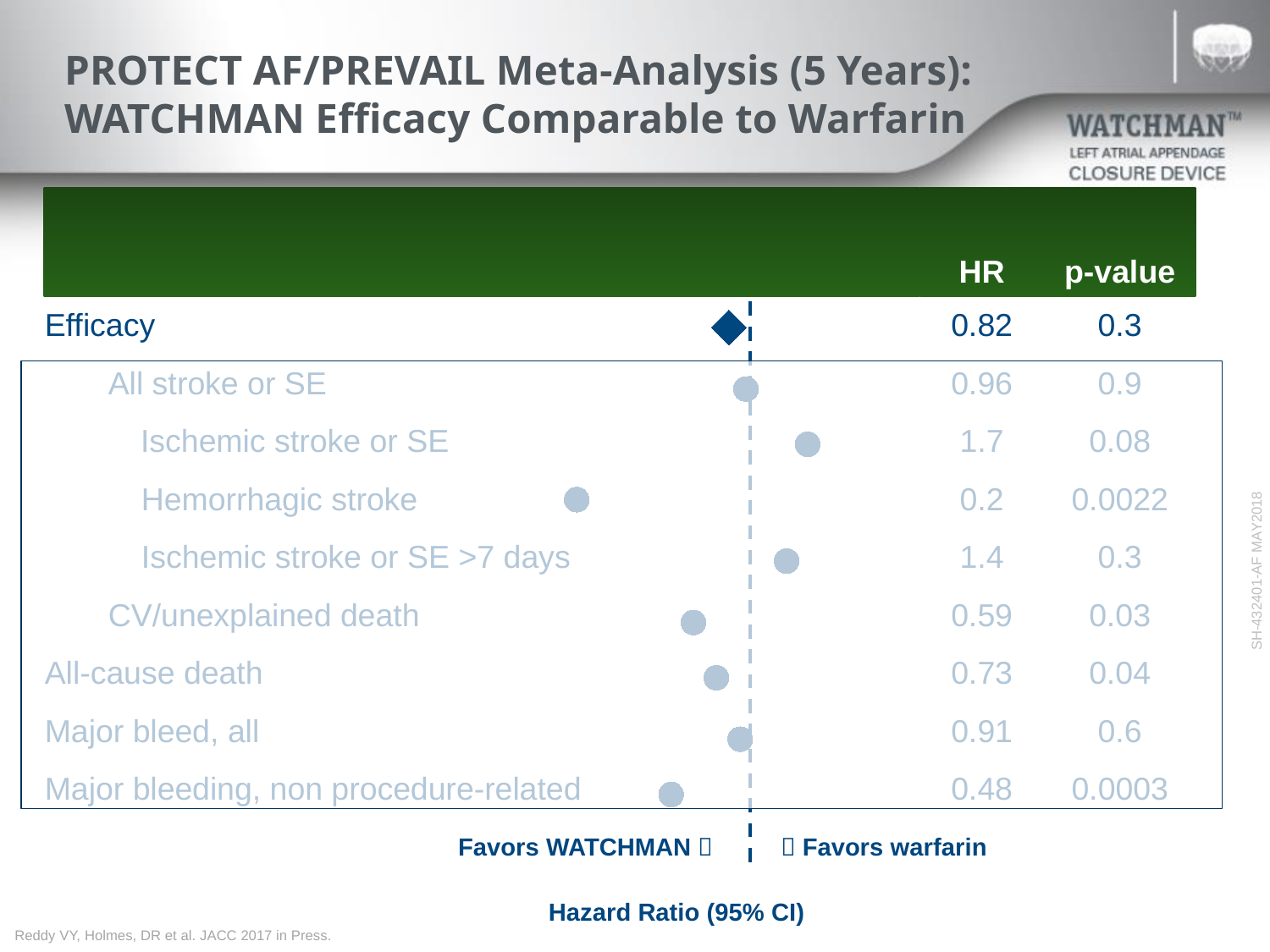
What is the hazard ratio (HR) shown for Efficacy? 0.82 What is the label of the horizontal axis at the bottom of the chart? Hazard Ratio (95% CI) Which outcome has the highest hazard ratio on the chart? Ischemic stroke or SE What is the p-value for All-cause death? 0.04 Which outcome has the lowest hazard ratio on the chart? Hemorrhagic stroke What kind of chart is shown on the slide? Forest plot (dot plot of hazard ratios) What is the difference between the HR for Ischemic stroke or SE and the HR for Hemorrhagic stroke? 1.5 Which has a larger HR: CV/unexplained death or All-cause death? All-cause death What is the HR for Major bleeding, non procedure-related? 0.48 Is the HR for Ischemic stroke or SE >7 days greater or less than 1? greater How many outcome rows are plotted on the chart? 9 What is the p-value shown for Hemorrhagic stroke? 0.0022